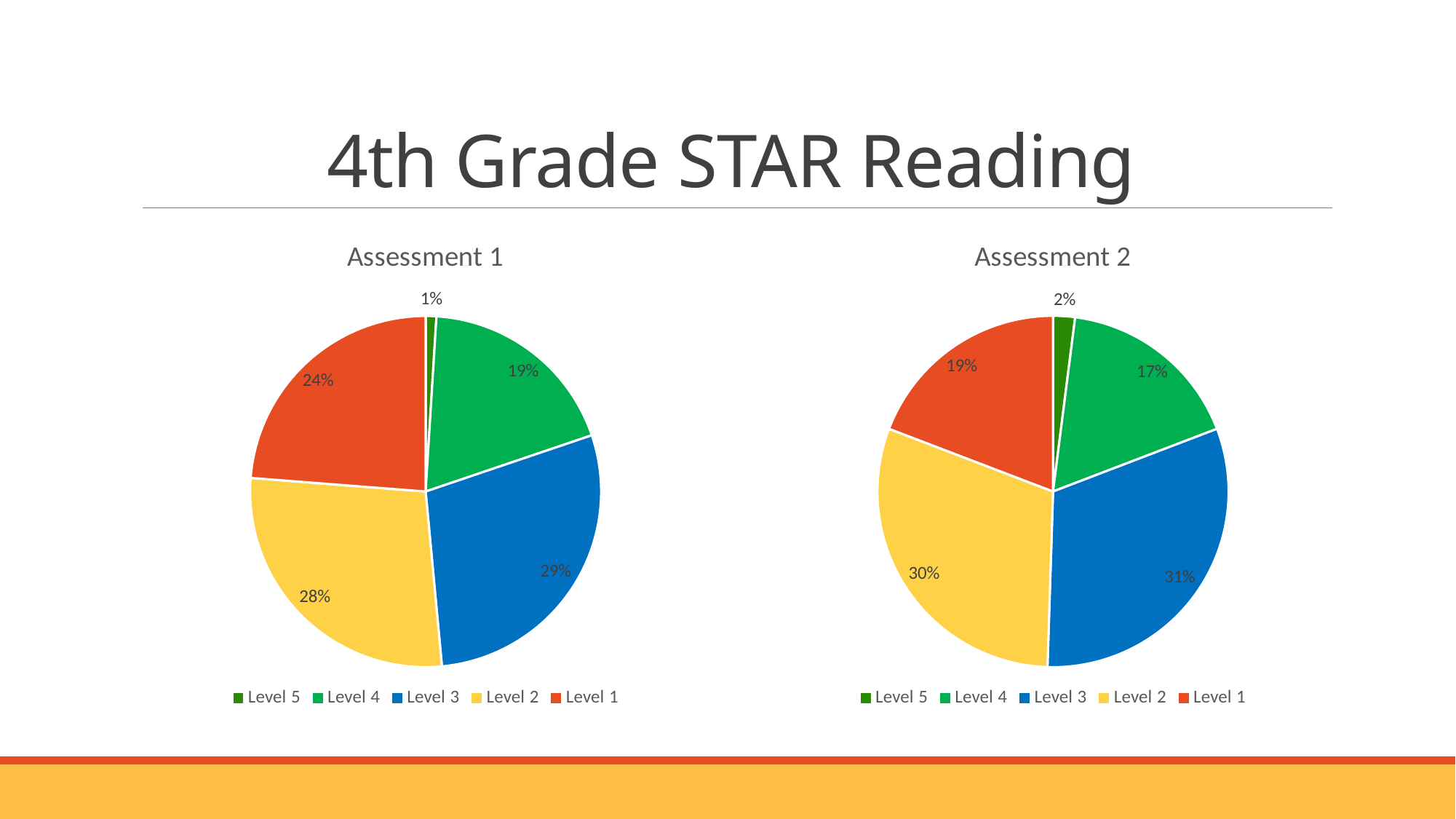
In the Assessment 1 chart, which colour represents Level 2? Yellow How many slices does the Assessment 2 pie chart have? 5 In the Assessment 1 chart, which level has the smallest share? Level 5 In the Assessment 2 chart, what percentage is Level 2? 30% In the Assessment 1 chart, what is the difference between the Level 2 and Level 1 shares? 4% In the Assessment 1 chart, what percentage is Level 3? 29% In the Assessment 2 chart, which level has the largest share? Level 3 In the Assessment 1 chart, what percentage is Level 5? 1% In the Assessment 1 chart, which is larger, Level 4 or Level 1? Level 1 In the Assessment 2 chart, what percentage is Level 1? 19% What type of chart is used for Assessment 1? Pie chart In the Assessment 2 chart, what is the difference between the Level 3 and Level 4 shares? 14%